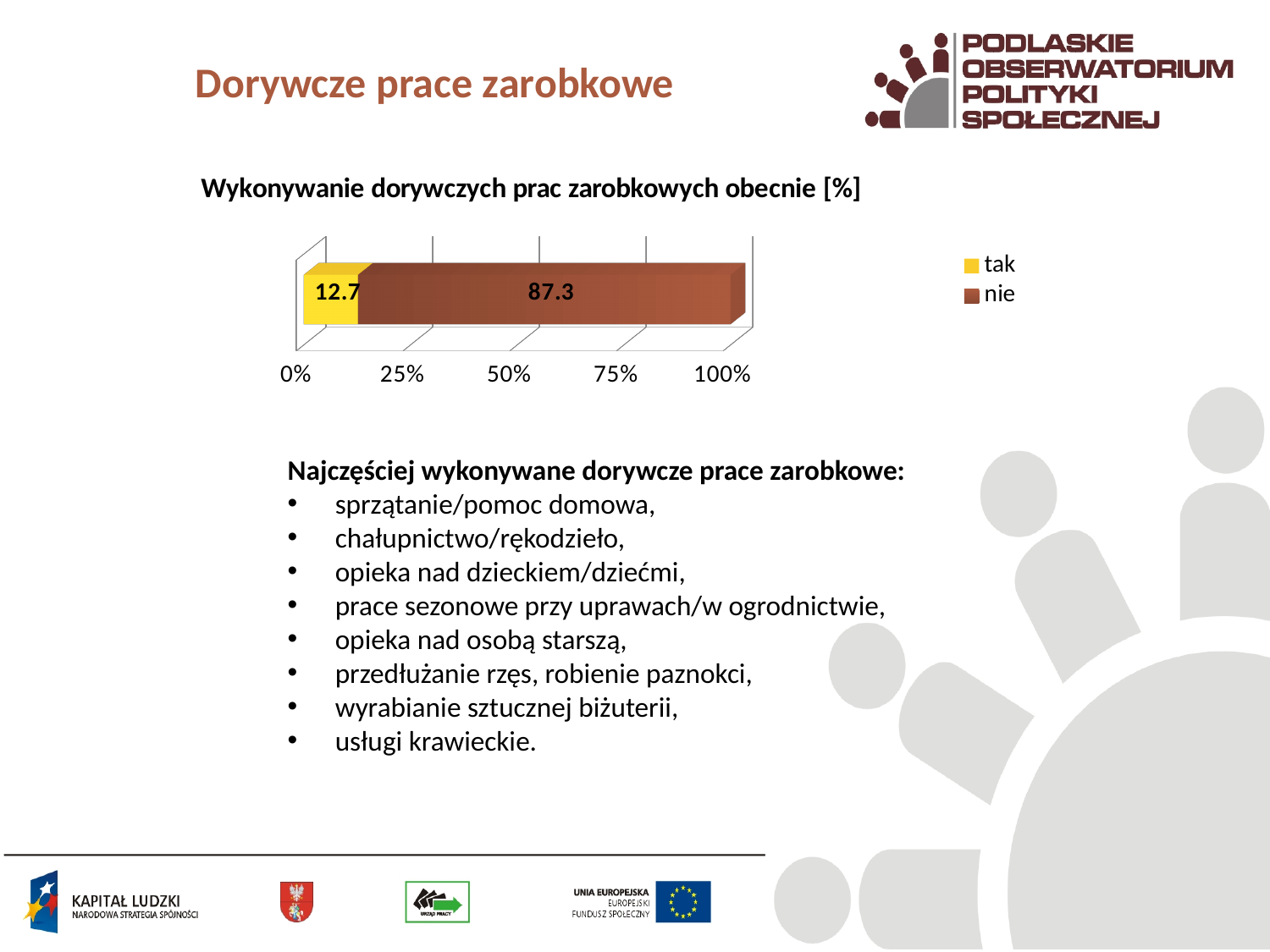
What colour represents the "tak" series in the chart? yellow Which series has the larger value, "tak" or "nie"? nie What is the value for "nie" in the chart? 87.3 Which series has the smallest value in the chart? tak What is the total of the stacked bar? 100 How many series does the legend list? 2 Is the value for "tak" greater or less than 25%? less What is the value for "tak" in the chart? 12.7 Is the value for "nie" greater or less than 75%? greater What is the title of the chart? Wykonywanie dorywczych prac zarobkowych obecnie [%] What is the difference between the values for "nie" and "tak"? 74.6 What kind of chart is shown on the slide? stacked bar chart